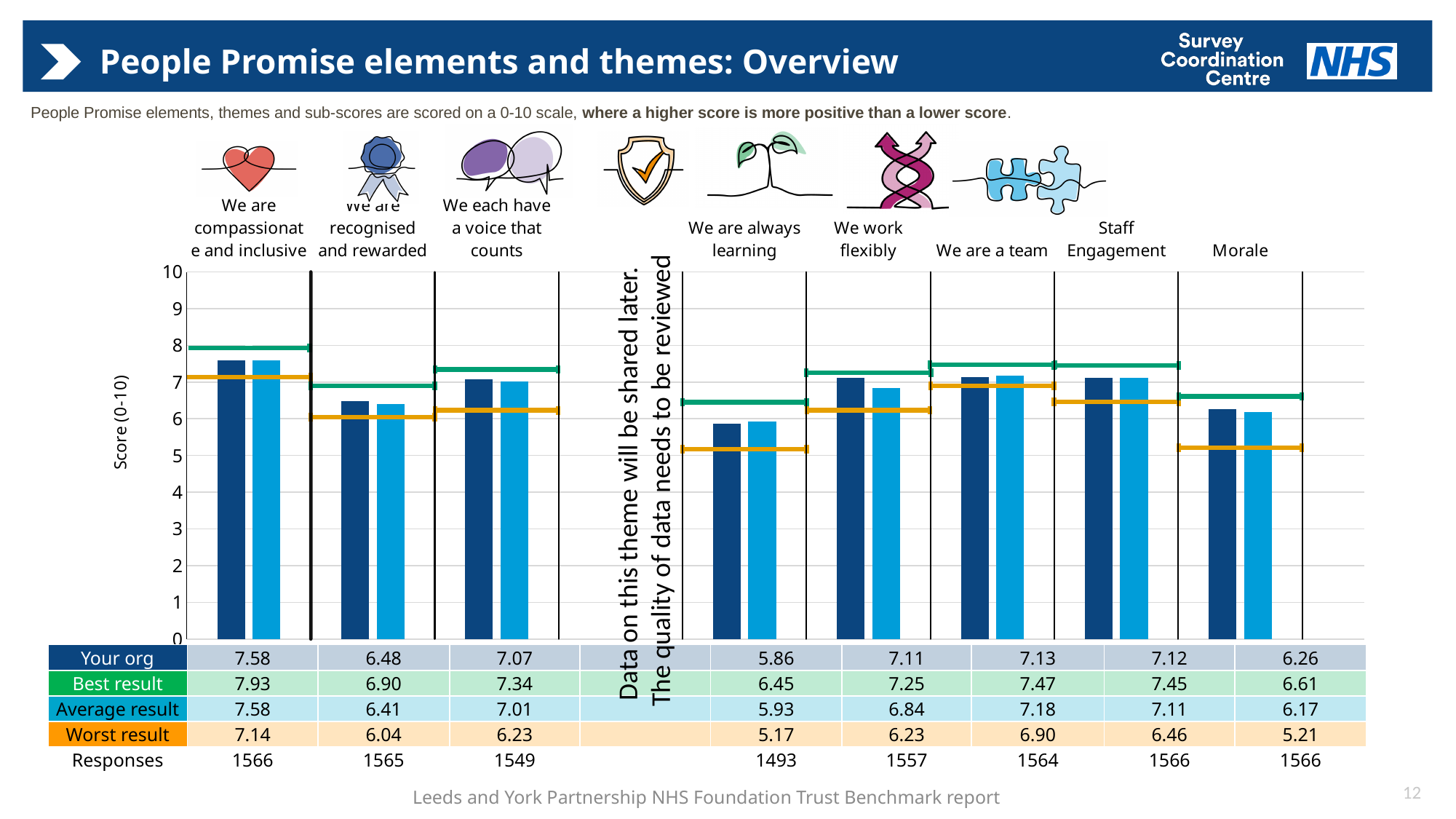
Which theme has the lowest 'Your org' score? We are always learning How many responses are recorded for 'We are always learning'? 1493 Which theme has the highest 'Your org' score? We are compassionate and inclusive What is the 'Best result' score for 'We are a team'? 7.47 For 'Morale', which is larger: the 'Your org' score or the 'Average result'? Your org What is the 'Your org' score for 'We are compassionate and inclusive'? 7.58 What is the difference between the 'Your org' score and the 'Average result' for 'We work flexibly'? 0.27 What is the 'Worst result' score for 'Morale'? 5.21 What kind of chart is shown on the slide? Bar chart What is the difference between the 'Best result' and the 'Worst result' for 'Morale'? 1.40 Is the 'Your org' score for 'We are always learning' greater or less than 6? less